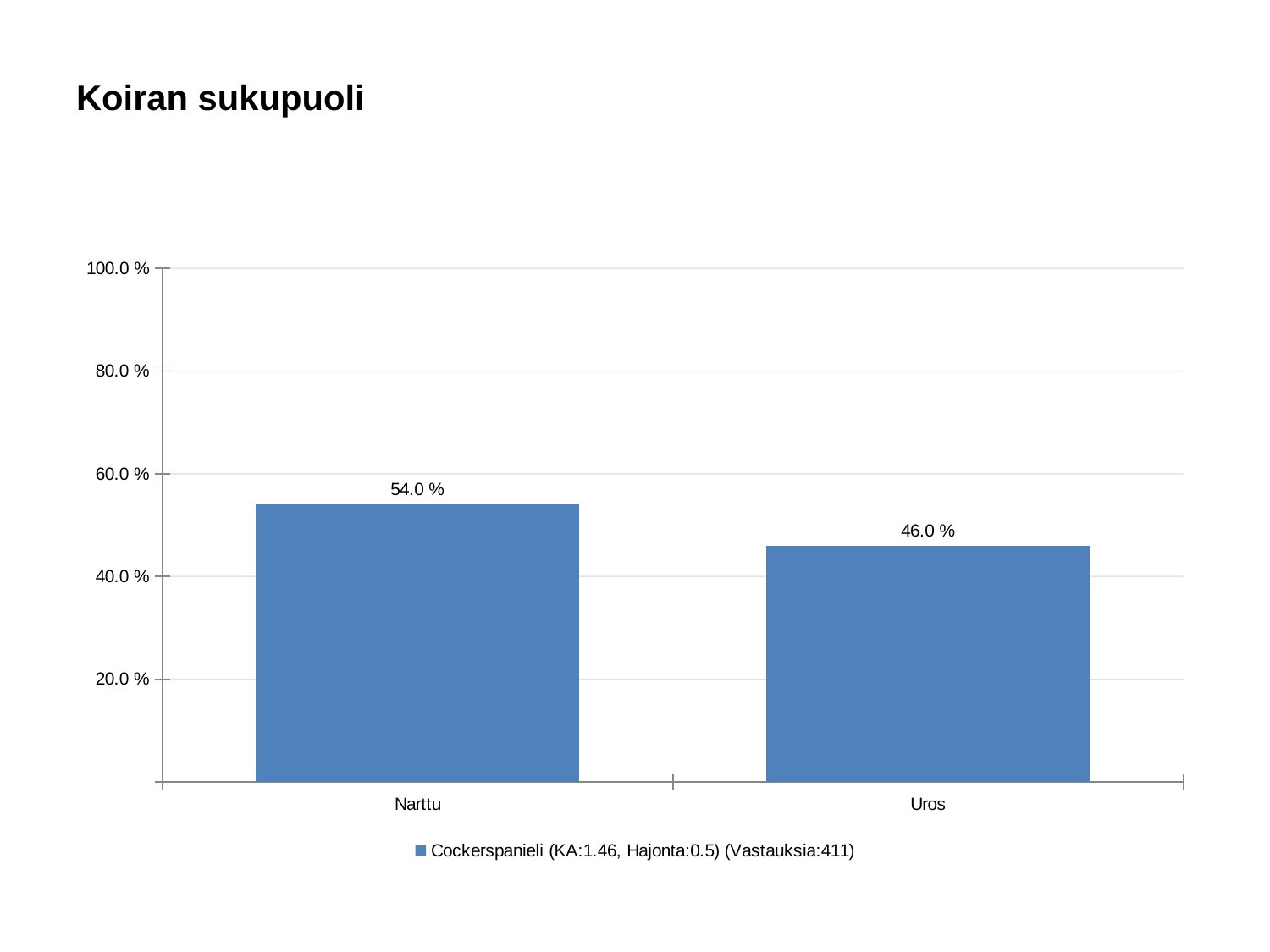
Which is larger, the value for Narttu or the value for Uros? Narttu Which category has the lowest value? Uros What is the value for Uros? 46.0 % What is the title of the slide? Koiran sukupuoli What is the value for Narttu? 54.0 % What is the difference between the values for Narttu and Uros? 8.0 % How many series does the legend list? 1 How many categories are shown on the x axis? 2 Is the value for Uros greater or less than 60.0 %? less Which category has the highest value? Narttu What kind of chart is shown on the slide? bar chart Is the value for Narttu greater or less than 40.0 %? greater